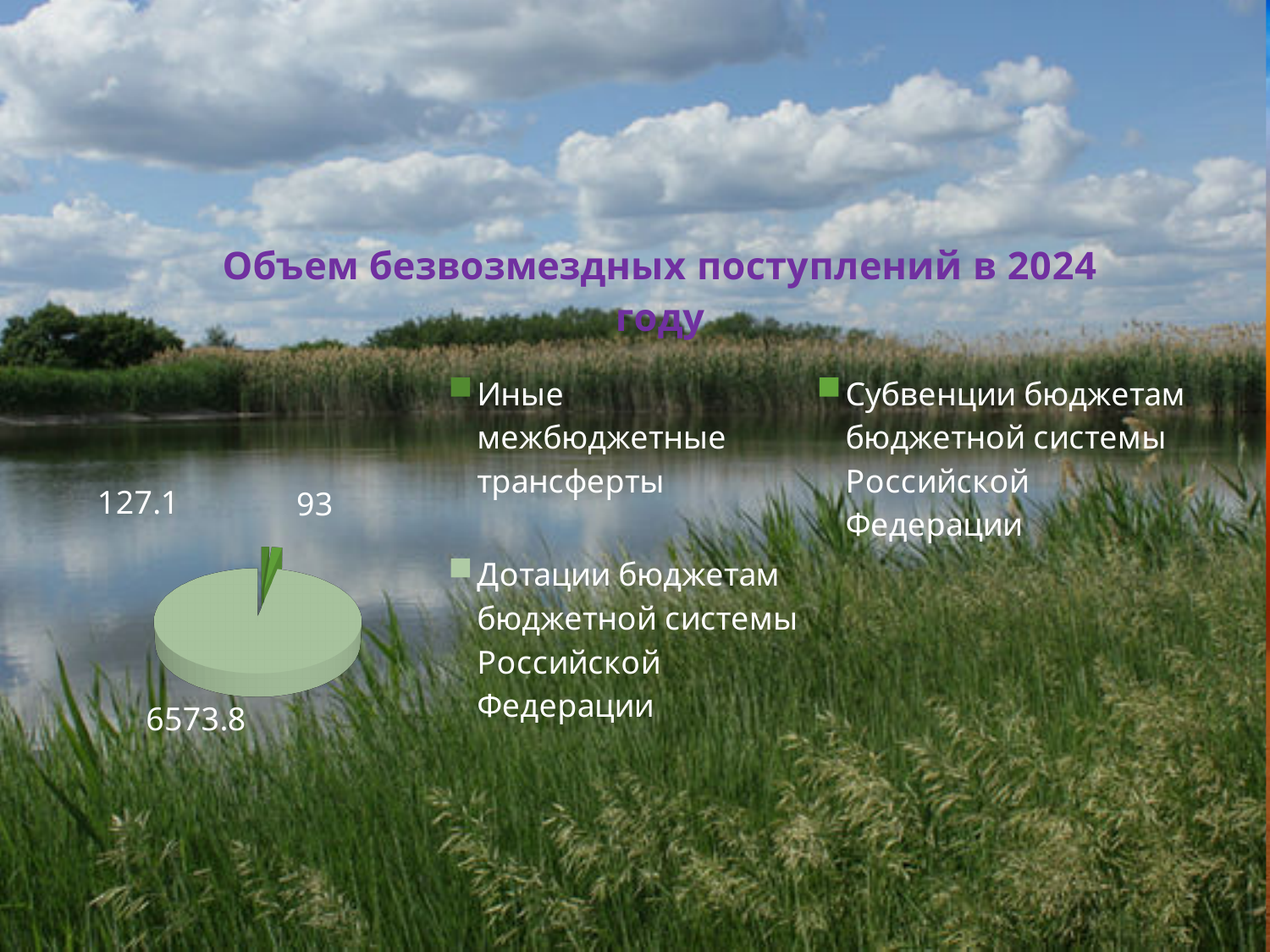
What is the smallest data label shown on the pie chart? 93 How many slices does the pie chart have? 3 What is the value shown for Дотации бюджетам бюджетной системы Российской Федерации? 6573.8 What type of chart is shown on the slide? pie chart Which legend entry is listed first in the chart legend? Иные межбюджетные трансферты Which category has the largest slice in the pie chart? Дотации бюджетам бюджетной системы Российской Федерации What is the difference between the two smaller data labels, 127.1 and 93? 34.1 What is the total of all three values shown on the pie chart? 6793.9 What is the title of the chart? Объем безвозмездных поступлений в 2024 году Is the value for Дотации бюджетам бюджетной системы Российской Федерации greater or less than 6000? greater What is the difference between the largest value (6573.8) and the smallest value (93) on the chart? 6480.8 How many categories does the legend of the pie chart list? 3